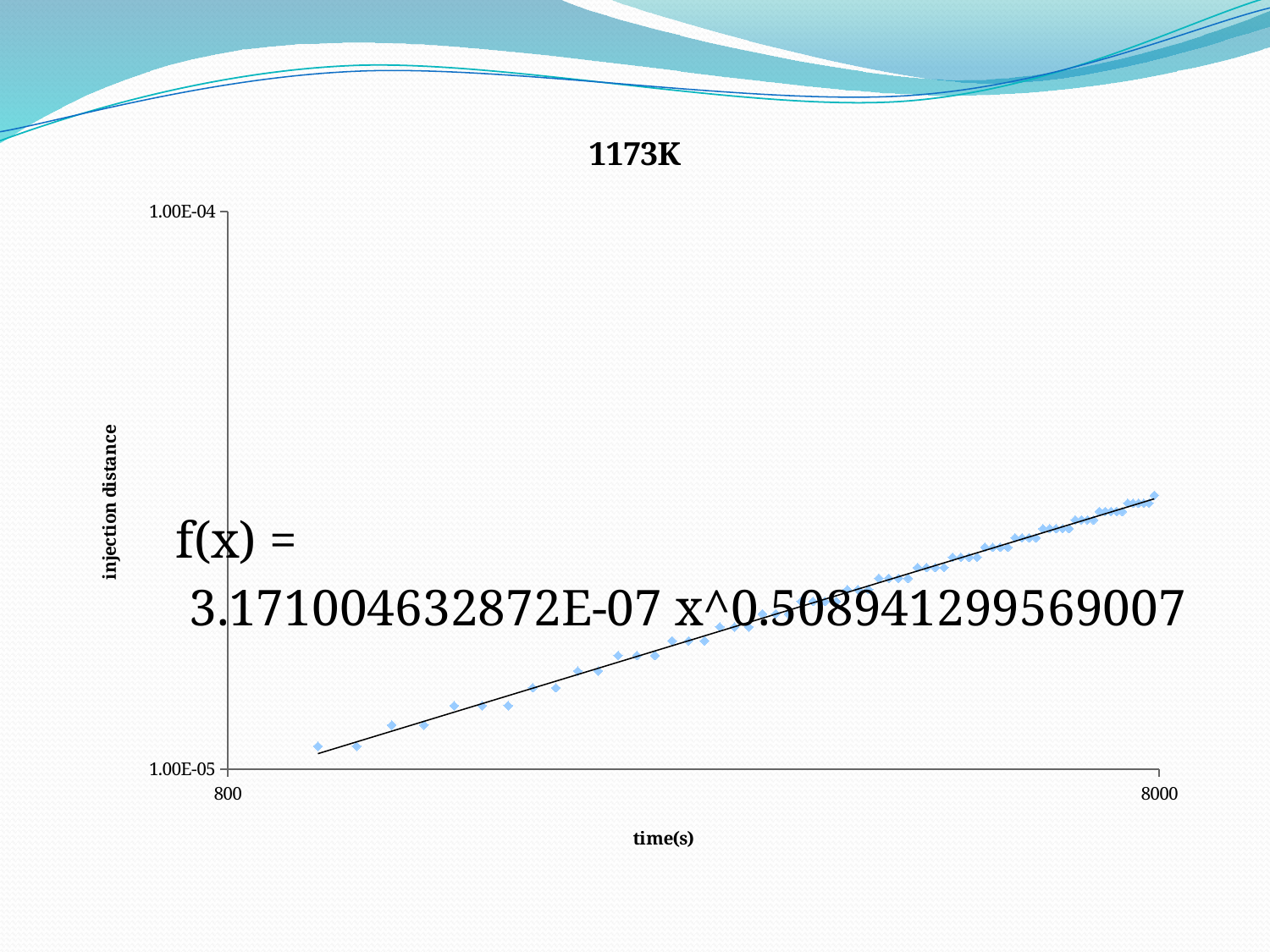
Do the plotted injection distance values rise or fall as time increases along the x axis? rise What kind of chart is shown on the slide? scatter chart What is the exponent of x in the fitted trendline equation shown on the chart? 0.508941299569007 What is the lowest value shown on the y axis? 1.00E-05 What is the label of the x axis? time(s) Is the injection distance of the rightmost data point greater or less than 1.00E-05? greater What is the smallest tick value shown on the x axis? 800 What is the coefficient in the fitted trendline equation f(x) shown on the chart? 3.171004632872E-07 What is the largest tick value shown on the x axis? 8000 What is the highest value shown on the y axis? 1.00E-04 What is the title of the chart? 1173K Is the injection distance of the leftmost data point greater or less than 1.00E-04? less